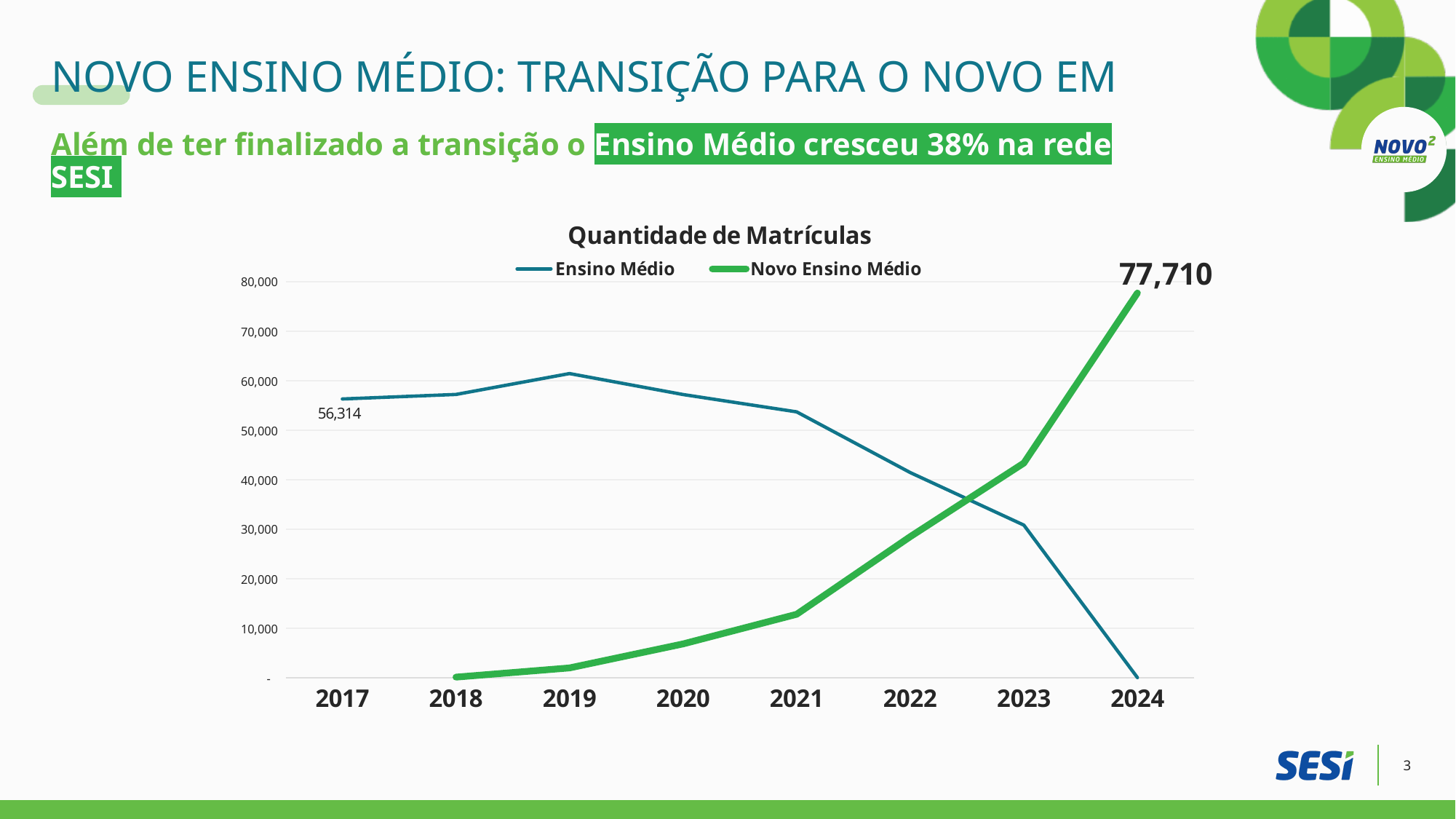
What kind of chart is shown on the slide? Line chart How many series does the legend list? 2 What is the value for Ensino Médio in 2017? 56,314 Does the Novo Ensino Médio series rise or fall from 2018 to 2024? Rise What is the value for Novo Ensino Médio in 2024? 77,710 Which series has the larger value in 2024, Ensino Médio or Novo Ensino Médio? Novo Ensino Médio Is the value for Novo Ensino Médio in 2023 greater or less than 40,000? greater In which year does Novo Ensino Médio reach its highest value? 2024 How many years are shown on the x axis? 8 What is the difference between the Novo Ensino Médio value in 2024 and the Ensino Médio value in 2017? 21,396 Is the value for Novo Ensino Médio in 2020 greater or less than 10,000? less What is the title of the chart? Quantidade de Matrículas